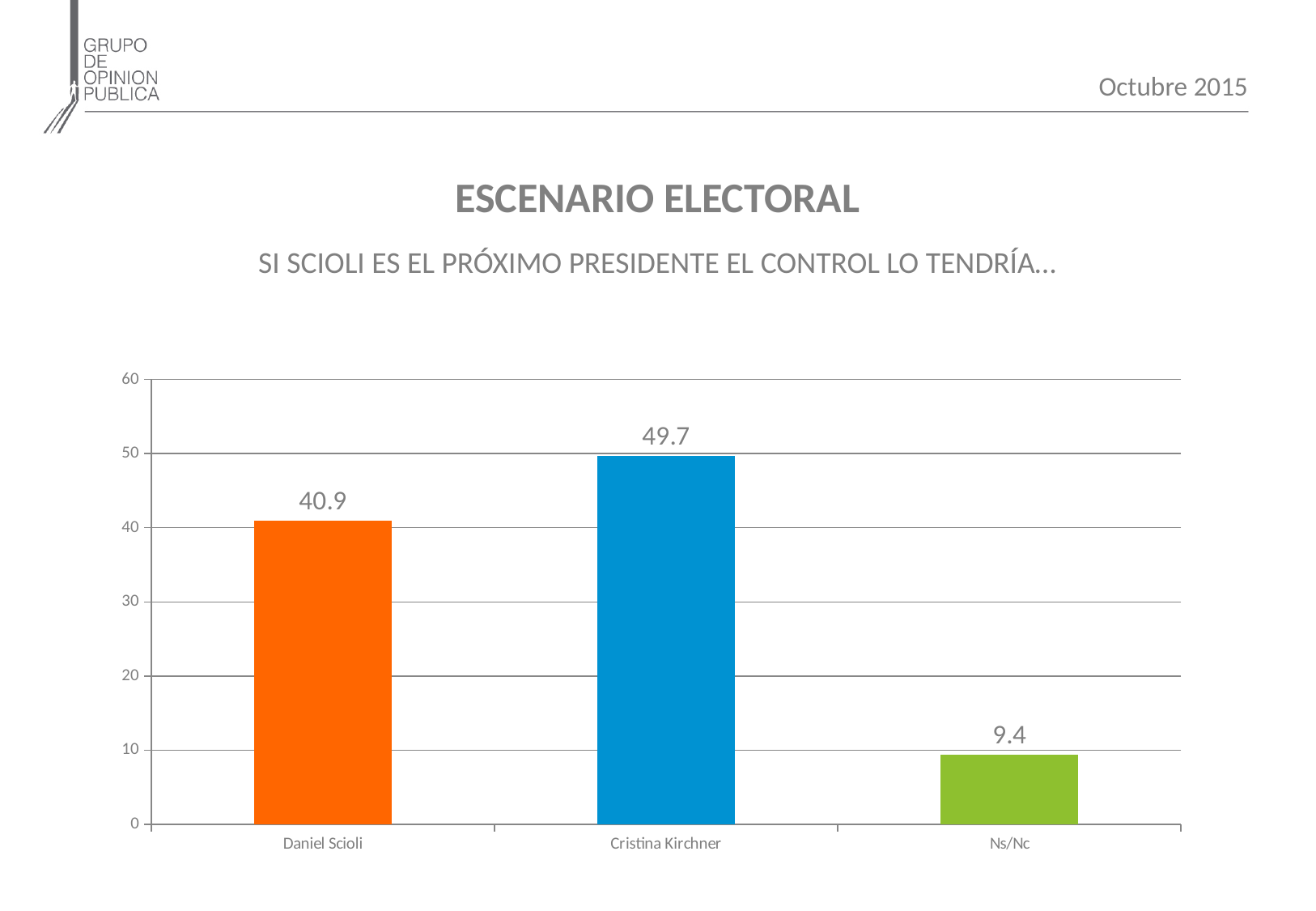
What is the value for Ns/Nc? 9.4 Which category has the lowest value? Ns/Nc What kind of chart is shown on the slide? bar chart How many categories are shown on the chart? 3 What is the total of the three values shown on the chart? 100 Is the value for Cristina Kirchner greater or less than 40? greater Which is larger, the value for Daniel Scioli or the value for Ns/Nc? Daniel Scioli Which category has the highest value? Cristina Kirchner What is the value for Daniel Scioli? 40.9 What colour is the bar for Cristina Kirchner? blue What is the difference between the values for Cristina Kirchner and Daniel Scioli? 8.8 What is the value for Cristina Kirchner? 49.7